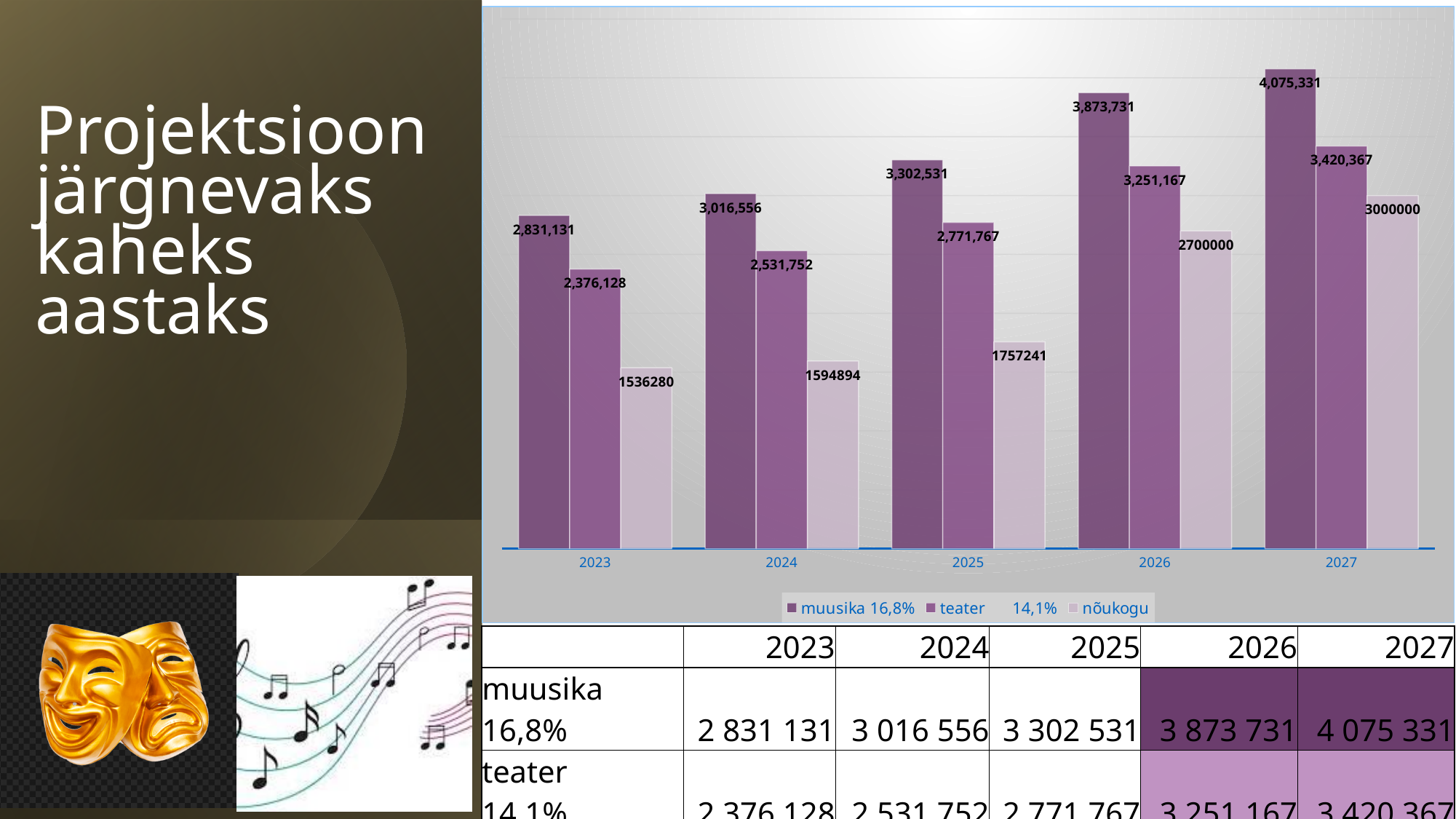
Which is larger in 2025: the teater 14,1% value or the nõukogu value? teater 14,1% What is the difference between the nõukogu values for 2027 and 2026? 300000 What is the value for teater 14,1% in 2024? 2,531,752 How many series does the chart legend list? 3 What is the difference between the muusika 16,8% values for 2027 and 2023? 1,244,200 In which year is the muusika 16,8% value highest? 2027 How many years are shown on the x axis of the chart? 5 What is the value for muusika 16,8% in 2025? 3,302,531 What is the value for nõukogu in 2026? 2700000 What type of chart is shown on the slide? bar chart Do the teater 14,1% values rise or fall from 2023 to 2027? rise In which year is the nõukogu value lowest? 2023